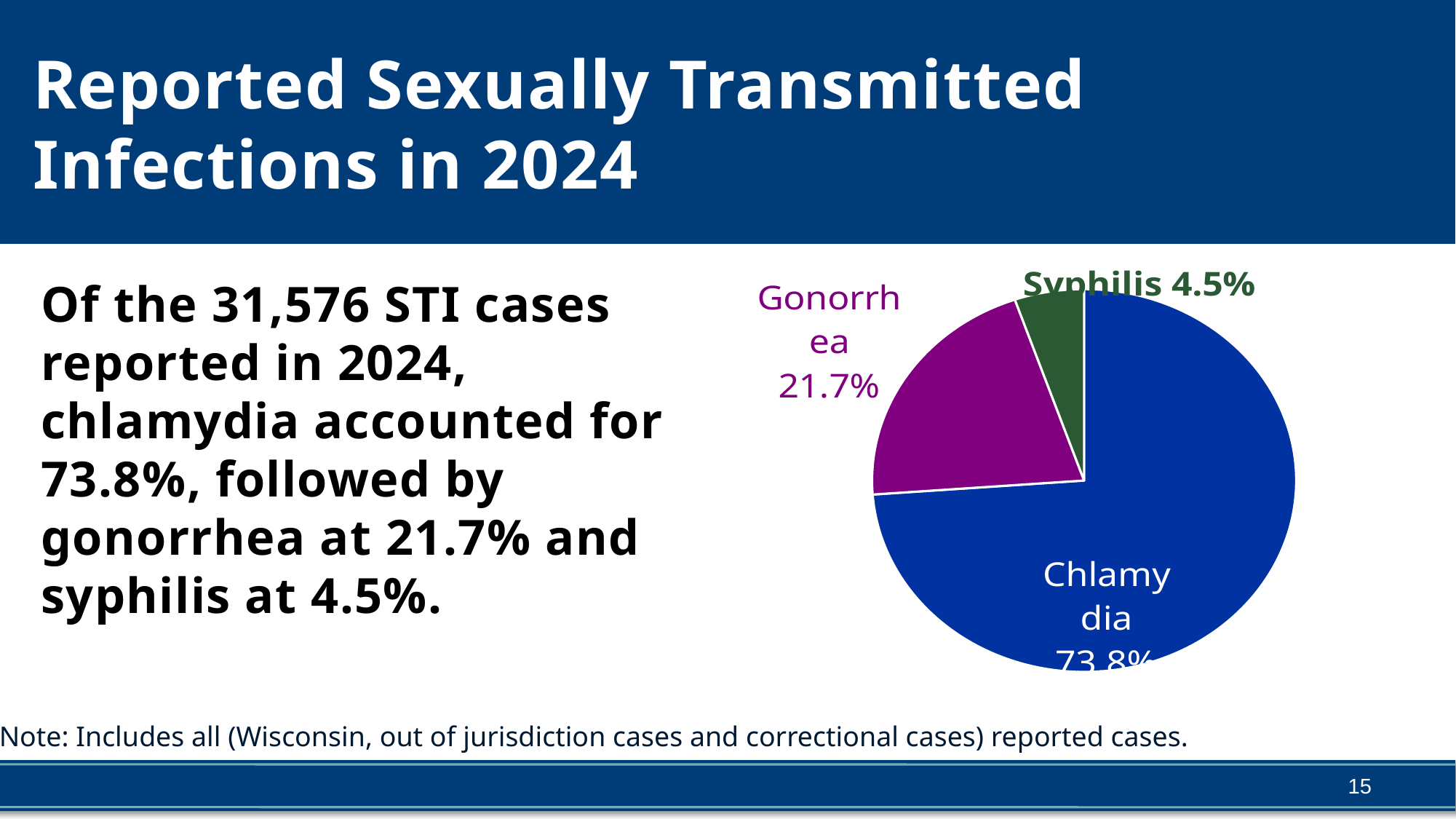
How many slices does the pie chart have? 3 What share of the pie does syphilis account for? 4.5% Which is larger, the gonorrhea slice or the syphilis slice? Gonorrhea What share of the pie does chlamydia account for? 73.8% What colour is the chlamydia slice of the pie? blue Which infection has the largest slice of the pie? Chlamydia What share of the pie does gonorrhea account for? 21.7% What colour is the gonorrhea slice of the pie? purple What is the difference in percentage points between the chlamydia share and the gonorrhea share? 52.1 Which infection has the smallest slice of the pie? Syphilis What is the difference in percentage points between the gonorrhea share and the syphilis share? 17.2 What kind of chart is shown on the slide? pie chart